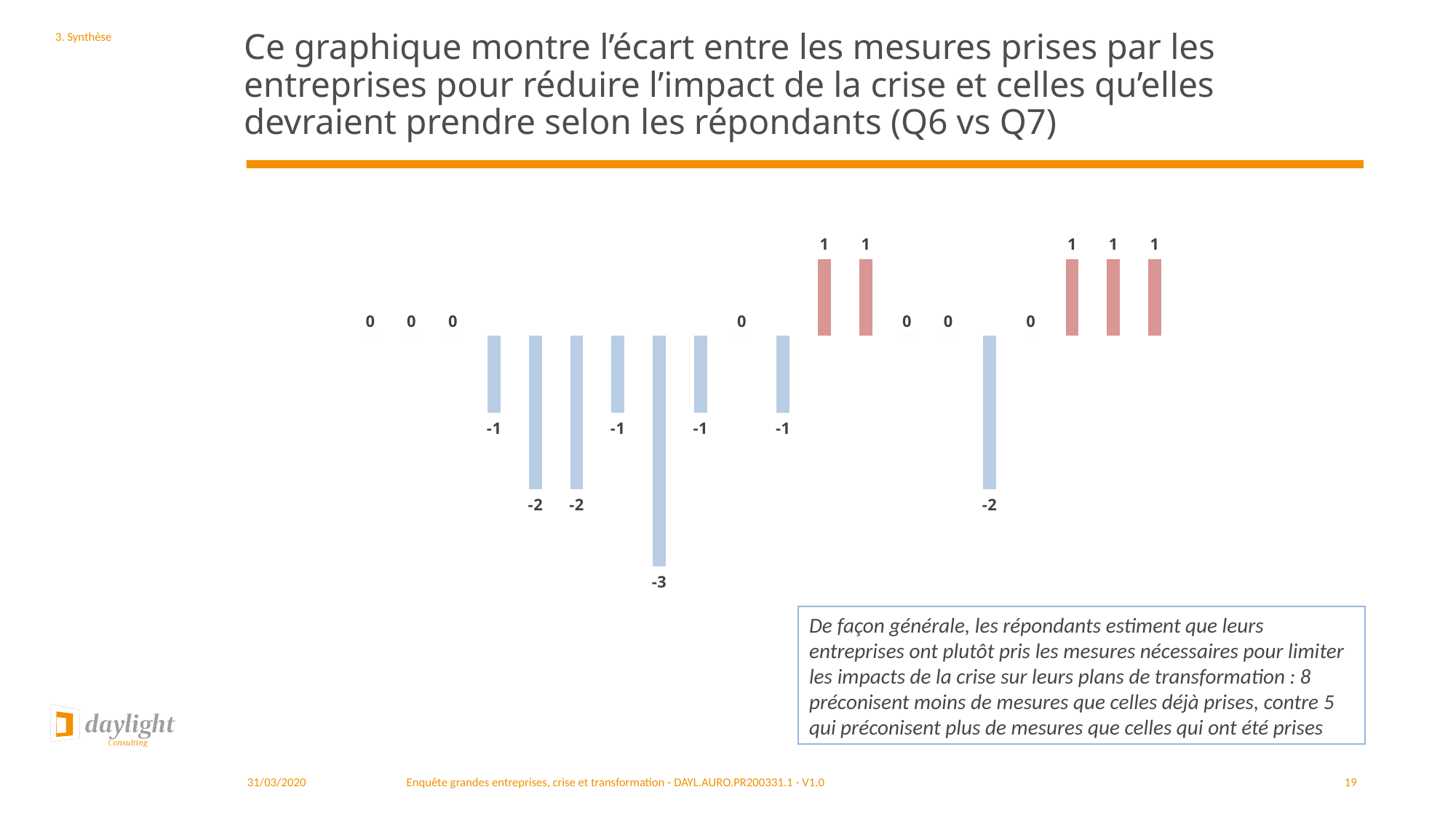
What is the highest value shown in the chart? 1 What is the lowest value shown in the chart? -3 What colour are the bars with positive values in the chart? red (pink) How many bars in the chart have a negative value? 8 How many bars in the chart have a value of -2? 3 What kind of chart is shown on the slide? bar chart What colour are the bars with negative values in the chart? light blue What is the difference between the highest value (1) and the lowest value (-3) in the chart? 4 How many bars in the chart have a value of 1? 5 Is the value of the tallest downward bar in the chart greater or less than -2? less